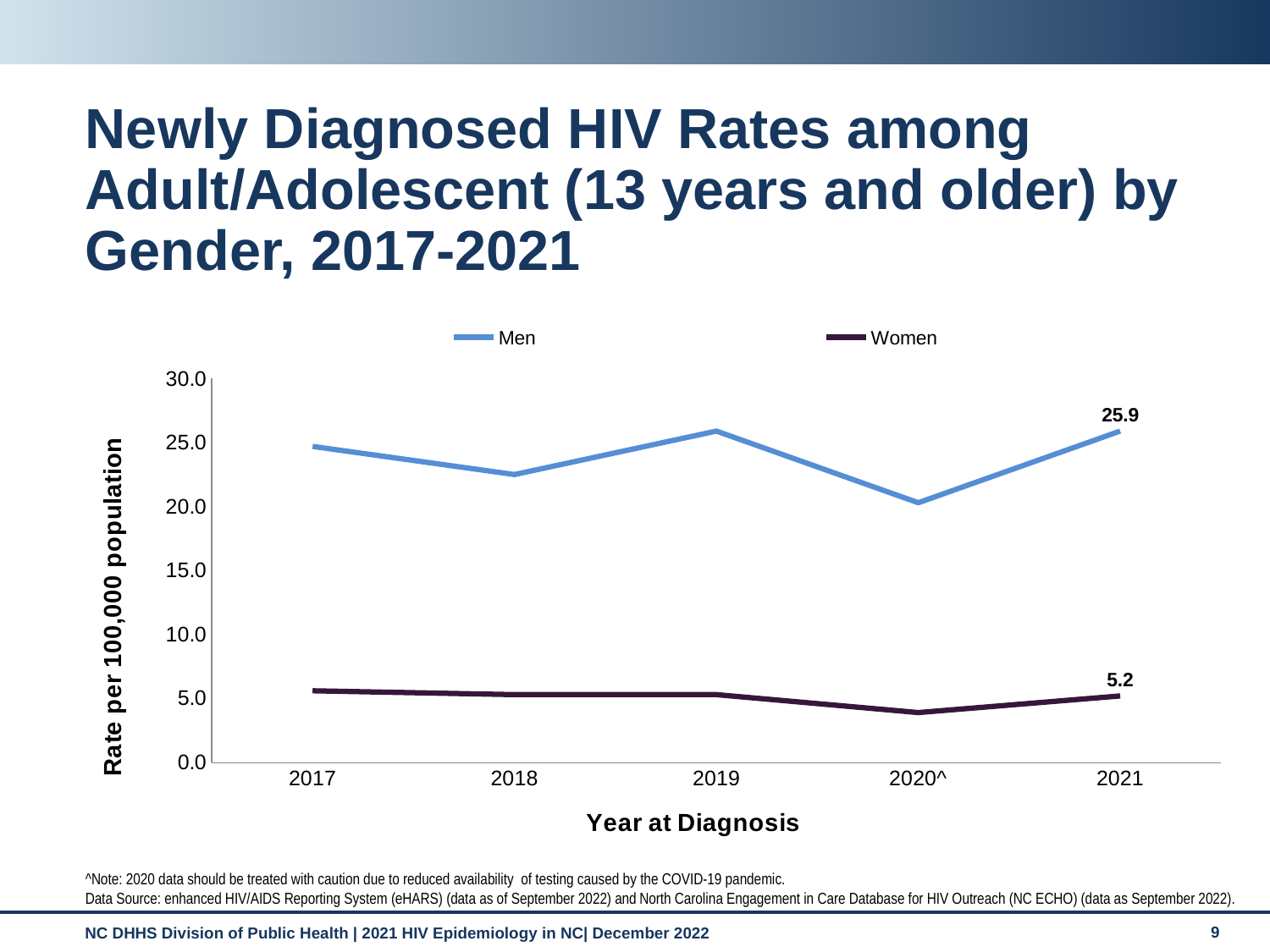
How many series does the legend list? 2 What is the difference between the Men and Women rates in 2021? 20.7 In 2021, which group has the higher rate, Men or Women? Men What is the rate for Women in 2021? 5.2 Is the value for Men in 2018 greater or less than 25.0? less What kind of chart is shown on the slide? Line chart In which year is the rate for Men lowest? 2020^ What is the rate for Men in 2021? 25.9 Is the value for Men in 2017 greater or less than 20.0? greater In which year is the rate for Women lowest? 2020^ How many years are shown on the x axis? 5 Is the value for Women in 2020^ greater or less than 5.0? less